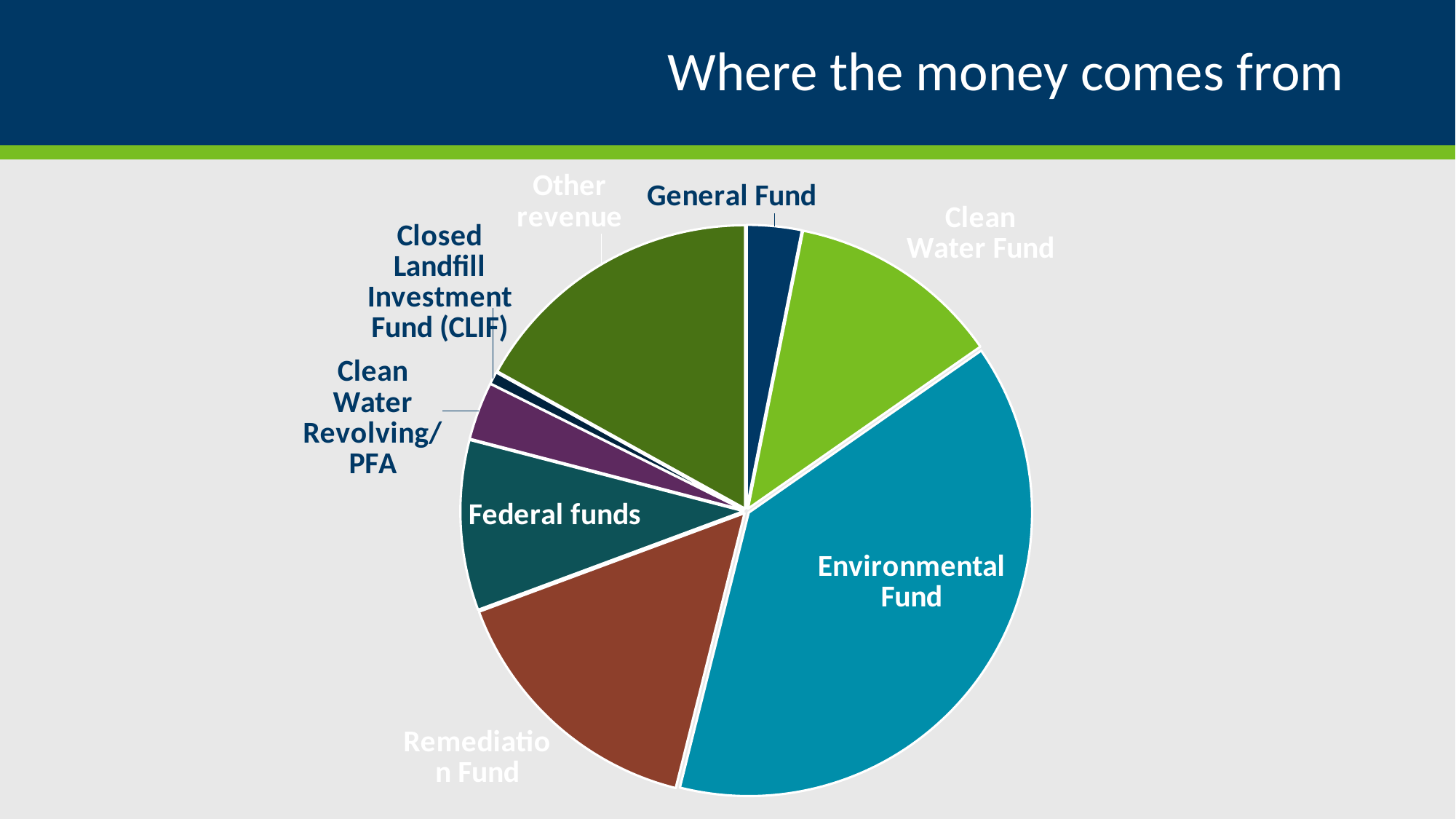
Which category has the smallest slice of the pie? Closed Landfill Investment Fund (CLIF) Which slice is larger, General Fund or Clean Water Fund? Clean Water Fund What is the title of the slide containing the pie chart? Where the money comes from What kind of chart is shown on the slide? Pie chart Which slice is larger, Clean Water Revolving/PFA or Closed Landfill Investment Fund (CLIF)? Clean Water Revolving/PFA Which category has the largest slice of the pie? Environmental Fund Which slice is larger, Environmental Fund or Remediation Fund? Environmental Fund What colour is the Environmental Fund slice? Teal blue How many slices does the pie chart have? 8